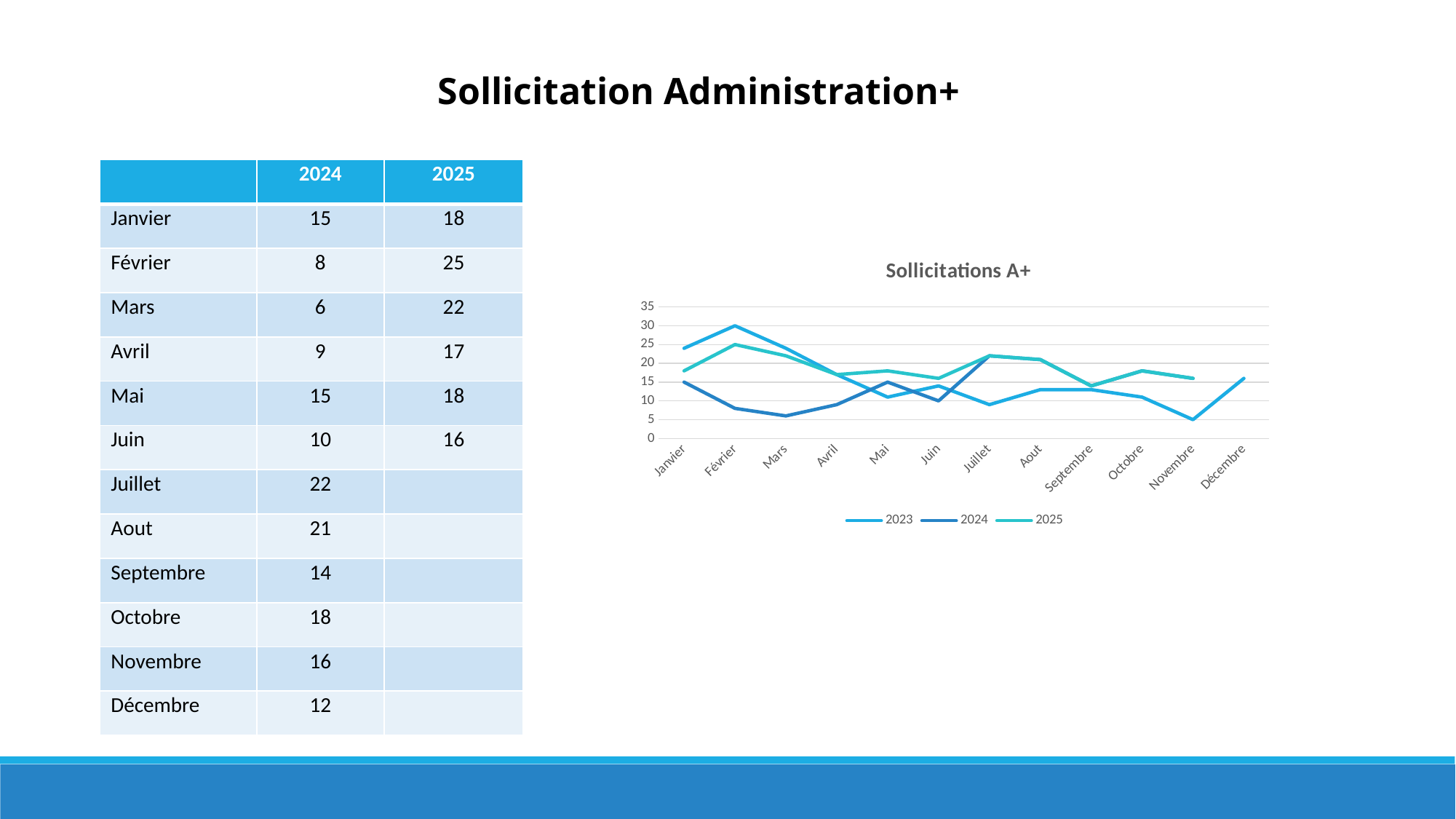
Is the value of the 2025 series for Février greater or less than 20? greater How many series does the legend of the chart list? 3 Which month has the lowest value for the 2023 series? Novembre In Février, which series has the higher value, 2023 or 2024? 2023 Is the value of the 2023 series for Novembre greater or less than 10? less Which series are listed in the chart legend? 2023, 2024, 2025 What is the title of the chart? Sollicitations A+ What is the value of the 2024 series for Janvier in the chart? 15 What type of chart is shown on the slide? line chart What is the value of the 2023 series for Février in the chart? 30 Does the 2023 series rise or fall from Octobre to Novembre? fall How many months are shown along the x axis of the chart? 12